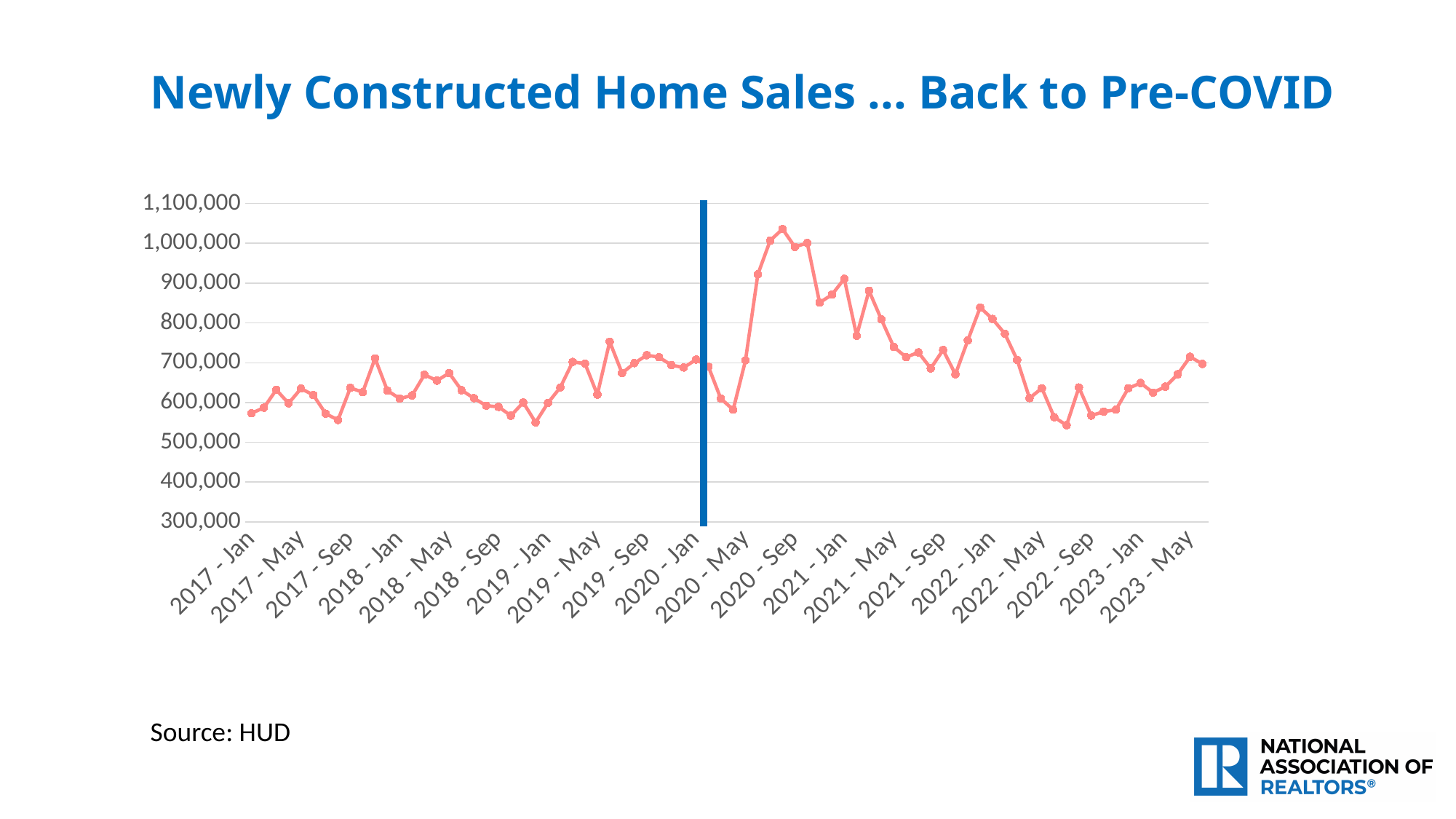
Is the value for 2020 - Sep greater or less than 900,000? greater What source is cited for the chart? HUD Do the values rise or fall between 2022 - Jan and 2022 - May? fall Is the value for 2017 - Jan greater or less than 600,000? less Do the values rise or fall between 2020 - May and 2020 - Sep? rise Is the value for 2022 - May greater or less than 700,000? less How many lines (data series) are plotted on the chart? 1 What is the title of the chart on the slide? Newly Constructed Home Sales … Back to Pre-COVID What kind of chart is shown on the slide? Line chart Which has the higher value, 2020 - Sep or 2017 - Jan? 2020 - Sep